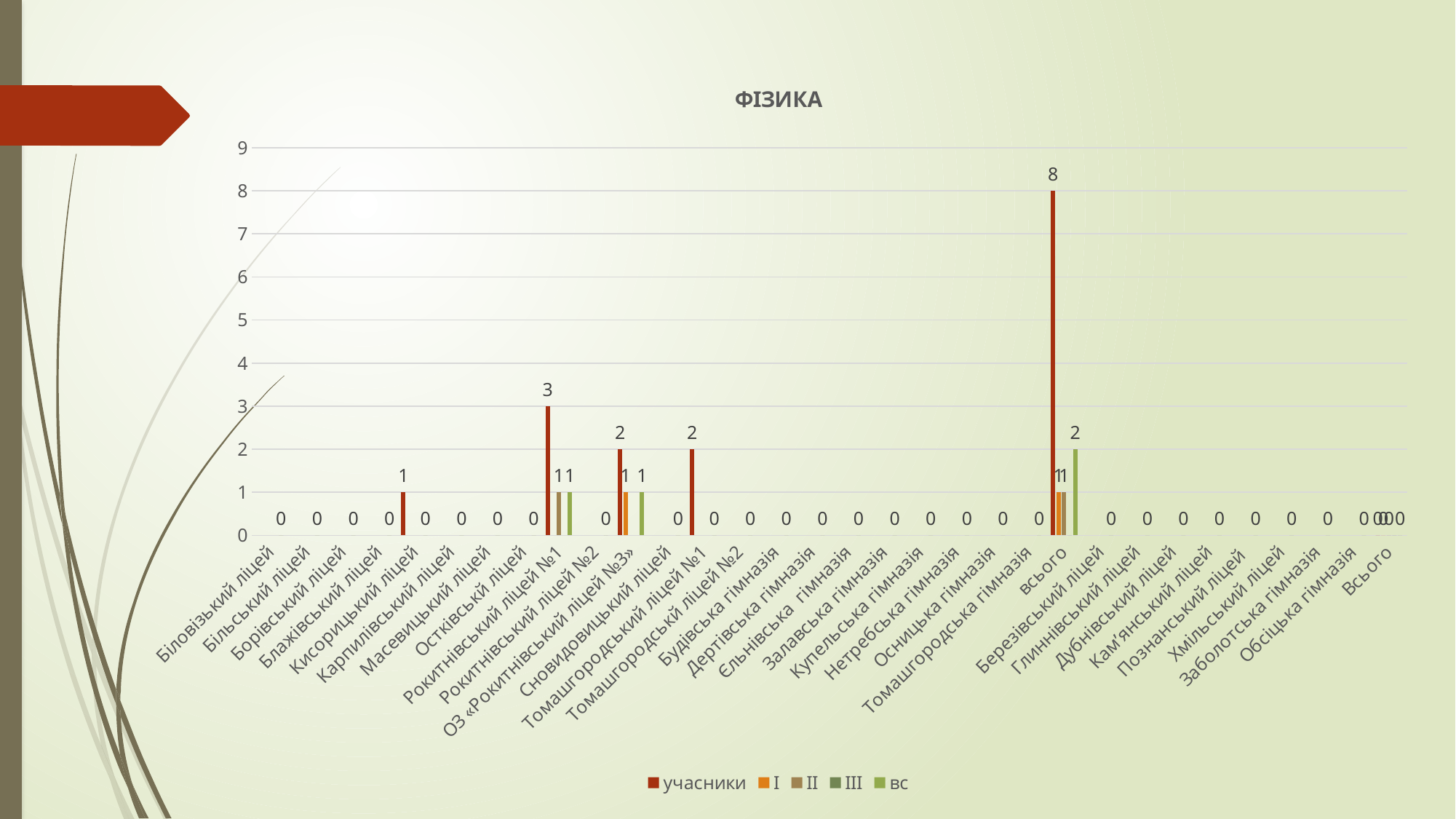
What is the value of учасники for Кисорицький ліцей? 1 What is the value of учасники for Томашгородський ліцей №1? 2 What is the difference between the учасники values for Рокитнівський ліцей №1 and Томашгородський ліцей №1? 1 What is the value of вс for the first всього category? 2 Which series is shown in dark red in the legend? учасники Which is larger: the учасники value for Рокитнівський ліцей №1 or for Кисорицький ліцей? Рокитнівський ліцей №1 What is the value of учасники for Рокитнівський ліцей №1? 3 How many series does the legend list? 5 What type of chart is shown on the slide? bar chart What is the title of the chart? ФІЗИКА Which category has the highest учасники value? всього What is the value of учасники for всього (the first всього category)? 8